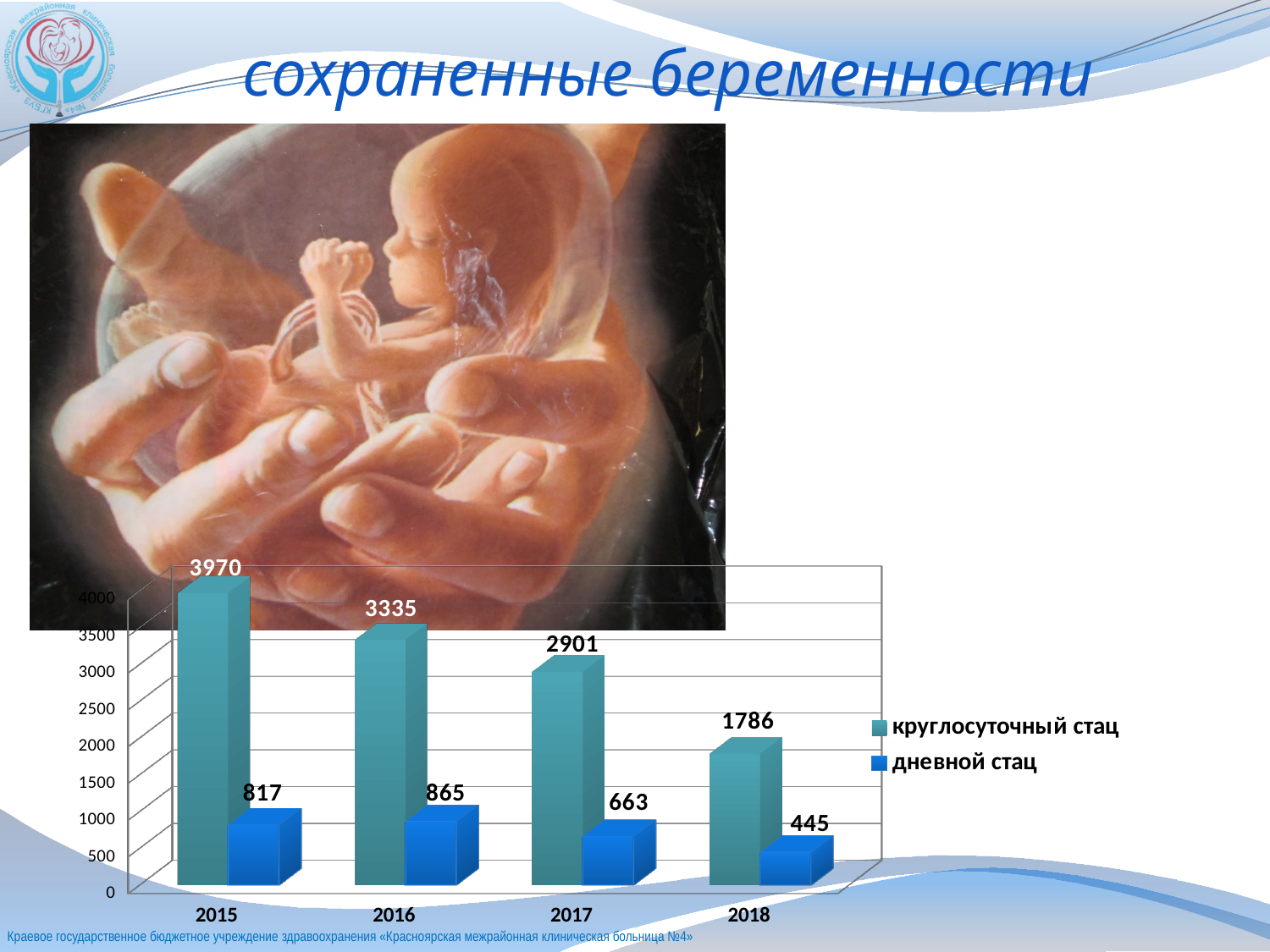
Which year has the lowest value for дневной стац? 2018 How many years are shown on the x axis? 4 Which is larger: дневной стац in 2015 or дневной стац in 2016? дневной стац in 2016 Which year has the highest value for круглосуточный стац? 2015 What is the value for дневной стац in 2016? 865 How many series does the legend list? 2 What is the value for дневной стац in 2017? 663 What is the value for круглосуточный стац in 2018? 1786 What kind of chart is shown on the slide? bar chart Do the values for круглосуточный стац rise or fall from 2015 to 2018? fall What is the difference between круглосуточный стац and дневной стац in 2017? 2238 What is the value for круглосуточный стац in 2015? 3970